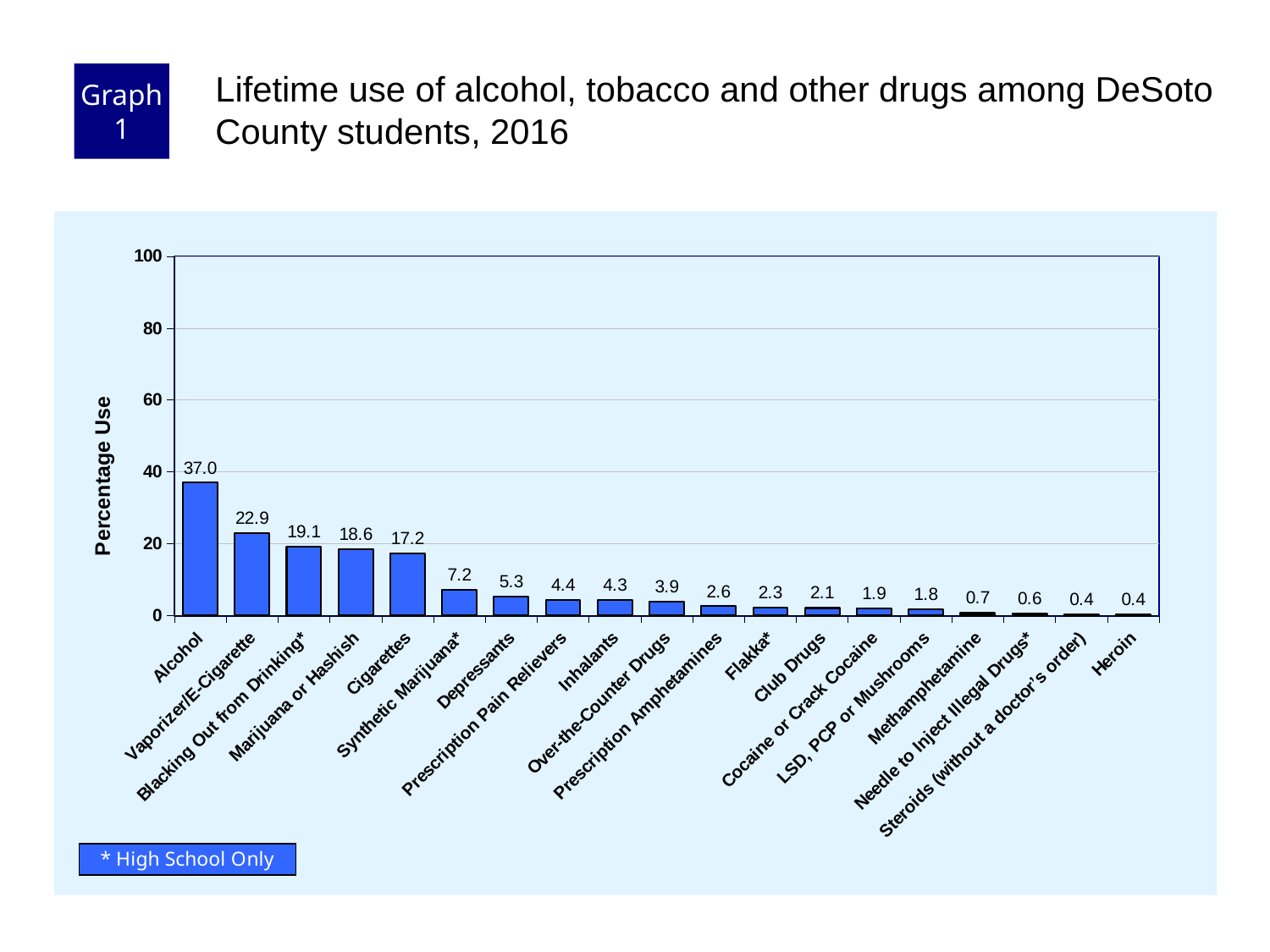
What is the percentage use for Methamphetamine? 0.7 How many categories are shown on the x axis? 19 What is the percentage use for Synthetic Marijuana*? 7.2 Which has a higher percentage use, Depressants or Inhalants? Depressants What is the percentage use for Alcohol? 37.0 What is the difference in percentage use between Blacking Out from Drinking* and Marijuana or Hashish? 0.5 What is the difference in percentage use between Alcohol and Cigarettes? 19.8 Which category has the highest percentage use? Alcohol What is the percentage use for Vaporizer/E-Cigarette? 22.9 What does the asterisk (*) after some category names indicate? High School Only What kind of chart is shown on the slide? Bar chart Is the value for Vaporizer/E-Cigarette greater or less than 20? greater